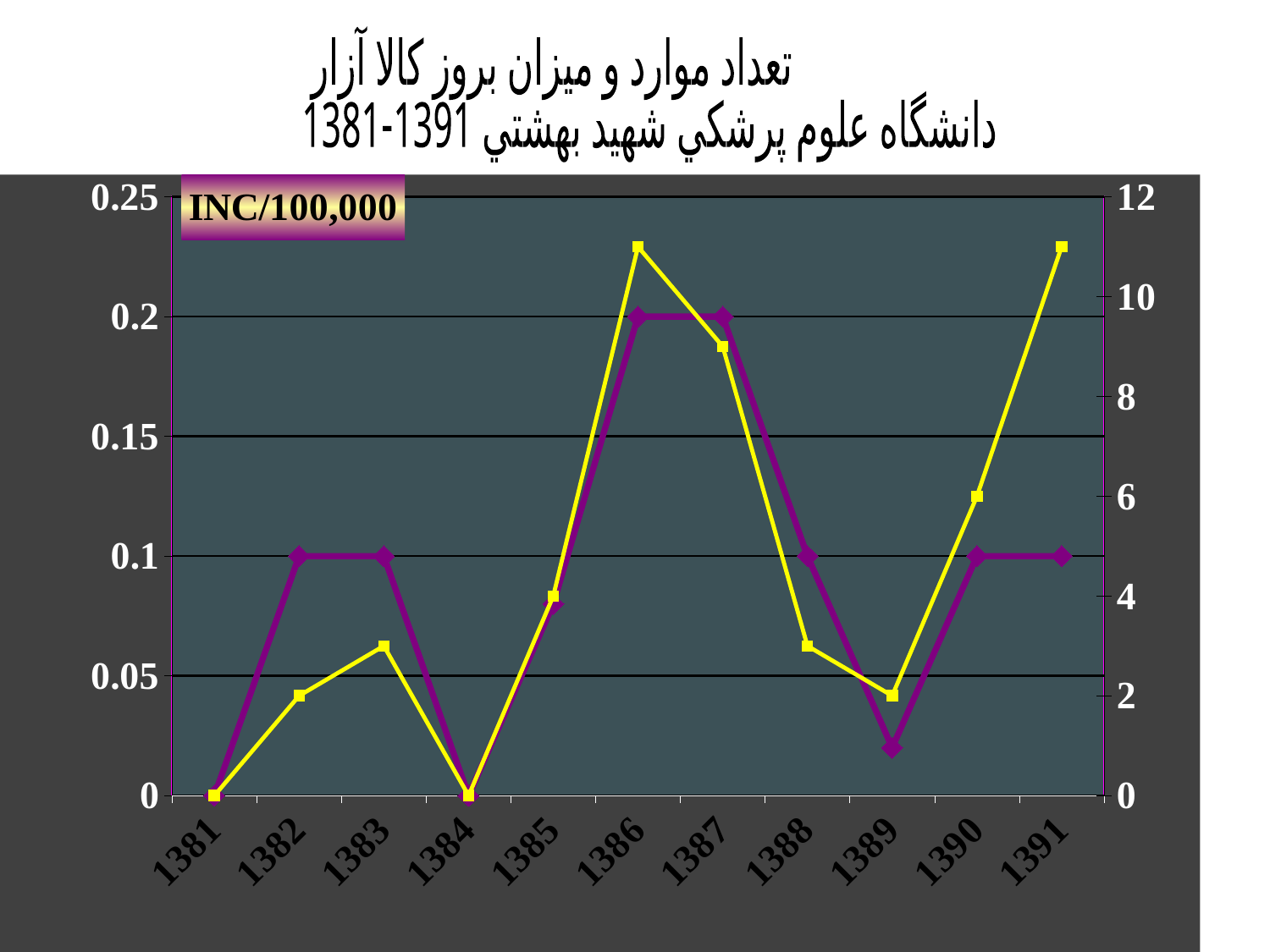
On the left axis, what value does the purple line have in 1384? 0 On the left axis, what value does the purple line reach in 1386? 0.2 Is the value of the purple line in 1389 greater or less than 0.05 on the left axis? less Is the value of the yellow line in 1386 greater or less than 10 on the right axis? greater What kind of chart is shown on the slide? line chart Which year has the larger value on the purple line, 1386 or 1389? 1386 What is the first year shown on the x axis? 1381 On the left axis, what value does the purple line have in 1382? 0.1 On the right axis, what value does the yellow line have in 1390? 6 How many years are shown along the x axis? 11 On the right axis, what value does the yellow line have in 1385? 4 What label is shown in the box at the top left of the plot area? INC/100,000